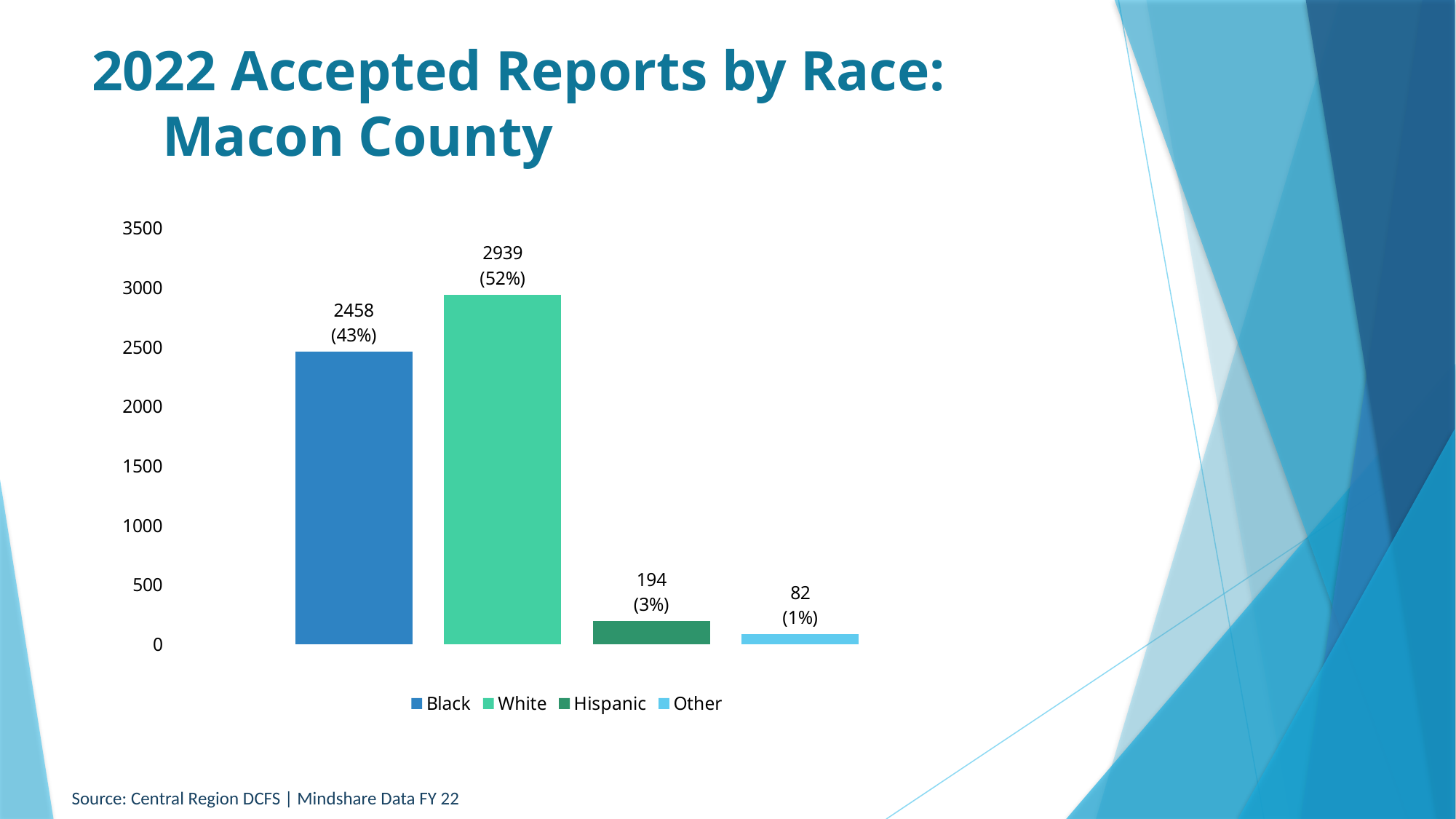
How many accepted reports were there for White? 2939 What is the source cited at the bottom of the slide? Central Region DCFS | Mindshare Data FY 22 Is the value for Black greater or less than 2000? greater How many accepted reports were there for Other? 82 Which race category has the highest number of accepted reports? White What percentage of accepted reports does the Hispanic bar represent? 3% What is the difference between the White and Black accepted report counts? 481 Which has more accepted reports, Hispanic or Other? Hispanic Which race category has the lowest number of accepted reports? Other How many accepted reports were there for Black in Macon County in 2022? 2458 What kind of chart is shown on the slide? Bar chart How many race categories are shown in the chart? 4